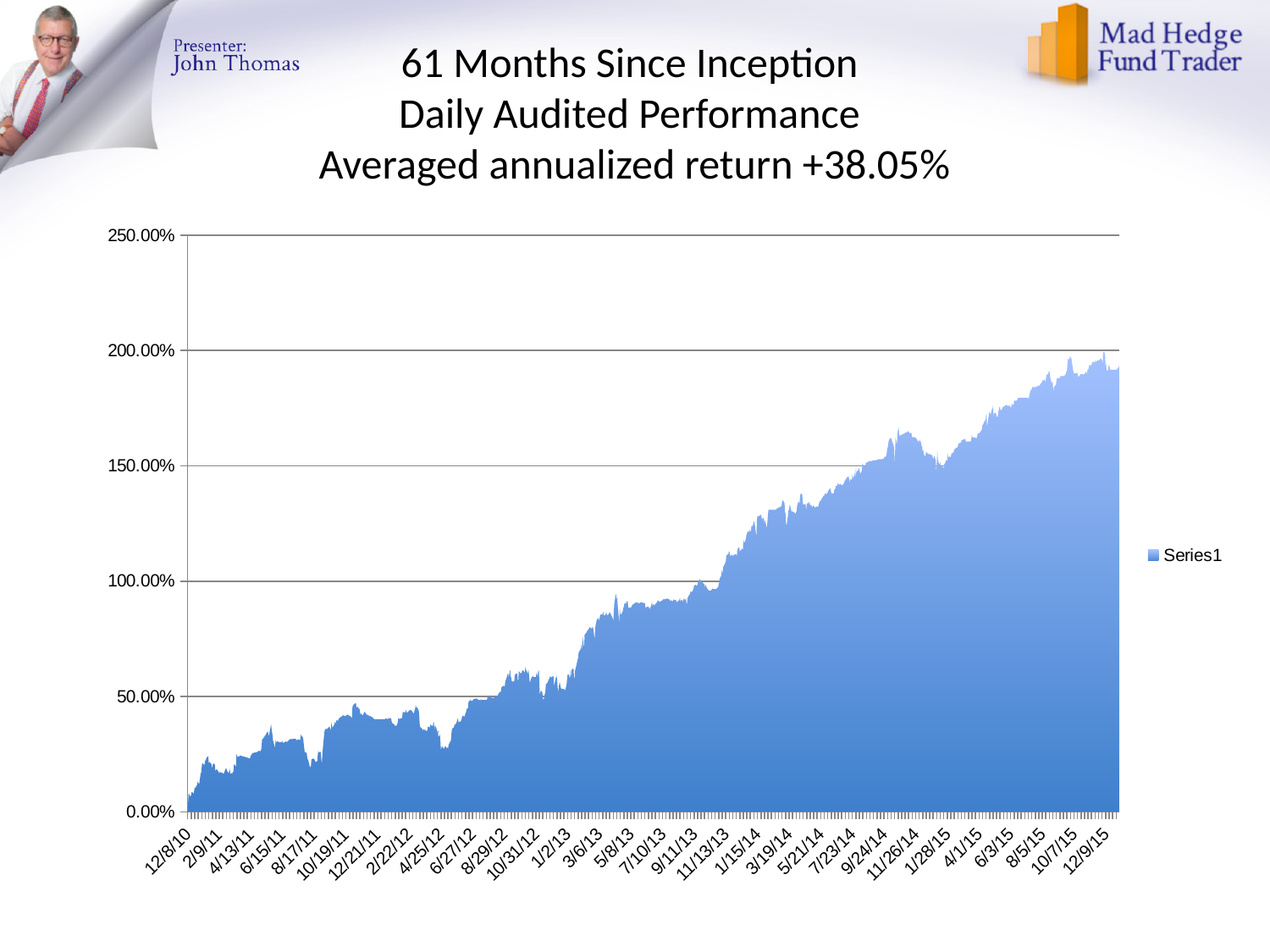
Is the value at 6/3/15 greater or less than 150%? greater Is the value at 12/8/10 greater or less than 50%? less What is the name of the series shown in the legend? Series1 How many series does the legend list? 1 What is the highest value shown on the vertical axis? 250.00% Is the value at 4/13/11 greater or less than 50%? less Overall, do the values rise or fall from 12/8/10 to 12/9/15? rise Which is larger, the value at 12/9/15 or the value at 12/8/10? 12/9/15 What kind of chart is shown on the slide? area chart